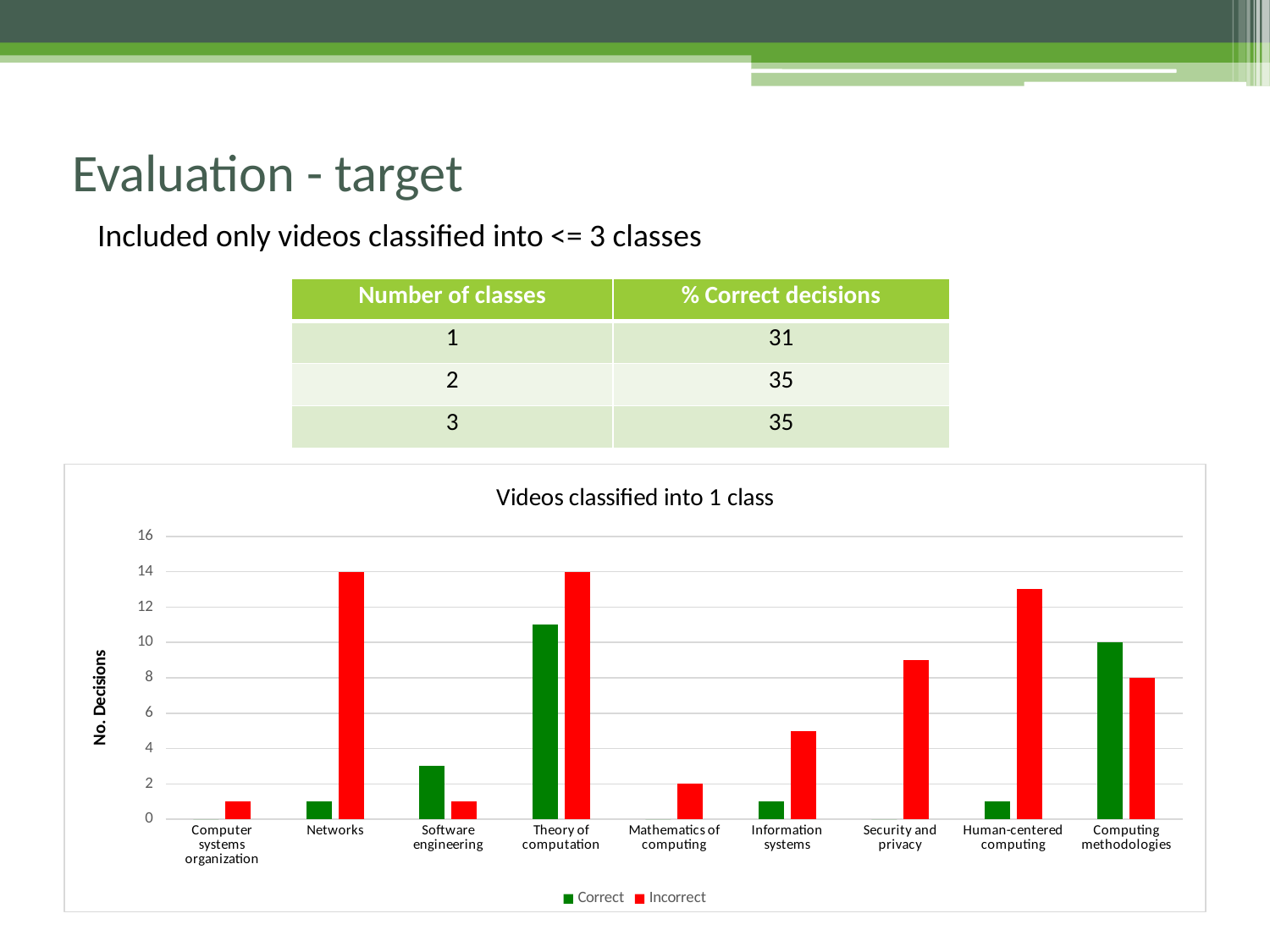
How many series does the chart legend list? 2 Which is larger for Security and privacy, the Correct value or the Incorrect value? Incorrect Is the Correct value for Software engineering greater or less than 4? less Which category has the highest Correct value? Theory of computation What is the Incorrect value for Computing methodologies? 8 Is the Incorrect value for Human-centered computing greater or less than 12? greater What is the Correct value for Computing methodologies? 10 What is the Incorrect value for Mathematics of computing? 2 How many categories are shown on the x axis of the chart? 9 What type of chart is shown on the slide? bar chart What is the title of the chart? Videos classified into 1 class What is the Incorrect value for Networks? 14